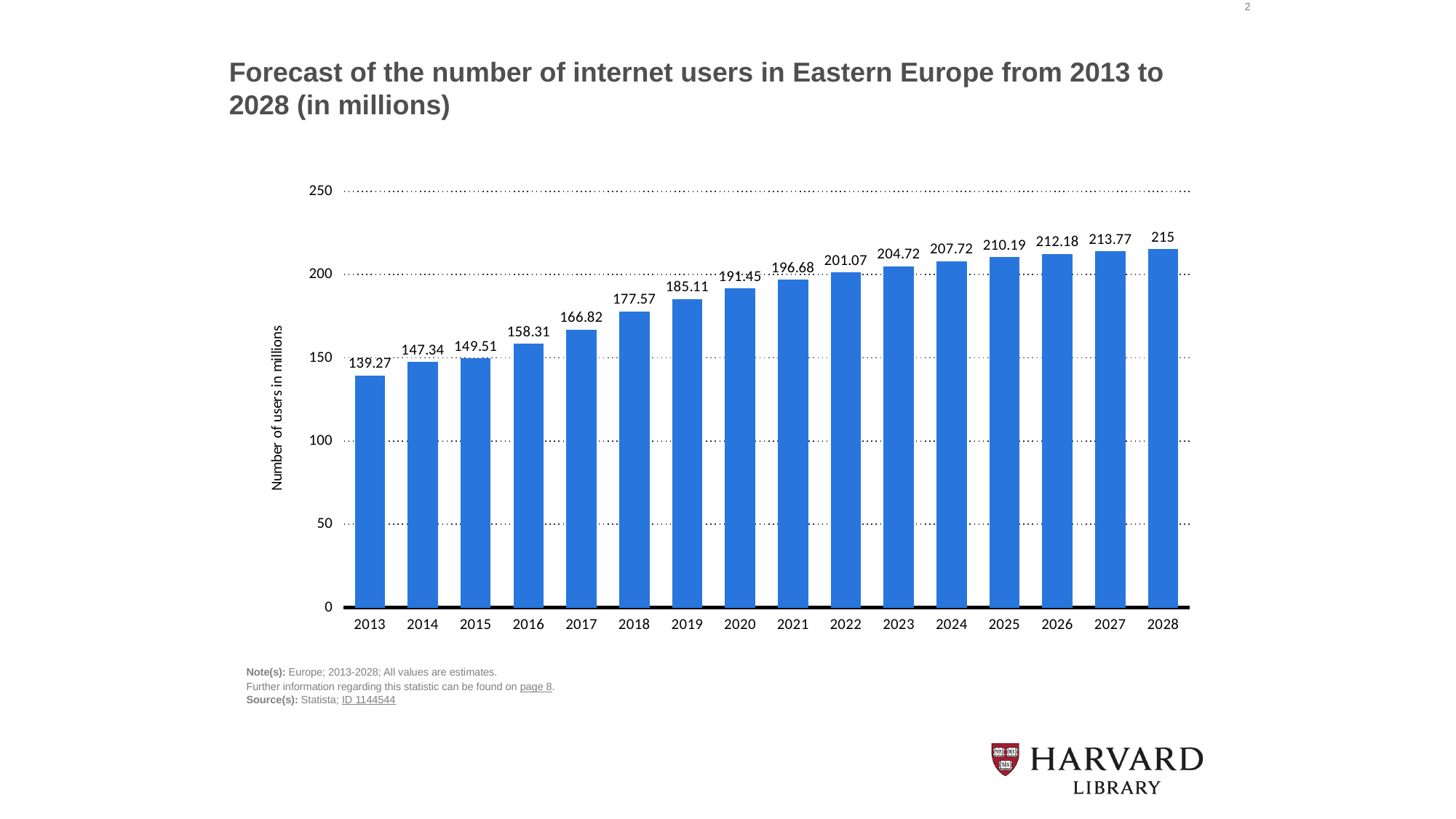
Is the value for 2022 greater or less than 200? greater What is the difference between the forecast values for 2028 and 2013? 75.73 What is the forecast number of internet users in Eastern Europe for 2020? 191.45 Which year has the lowest forecast number of internet users? 2013 What kind of chart is shown on the slide? Bar chart How many years are shown on the x axis? 16 Which year has a larger forecast value, 2016 or 2019? 2019 Which year has the highest forecast number of internet users? 2028 What is the forecast number of internet users in Eastern Europe for 2013? 139.27 Do the values rise or fall from 2013 to 2028? Rise What is the difference between the forecast values for 2018 and 2017? 10.75 What is the forecast number of internet users in Eastern Europe for 2028? 215